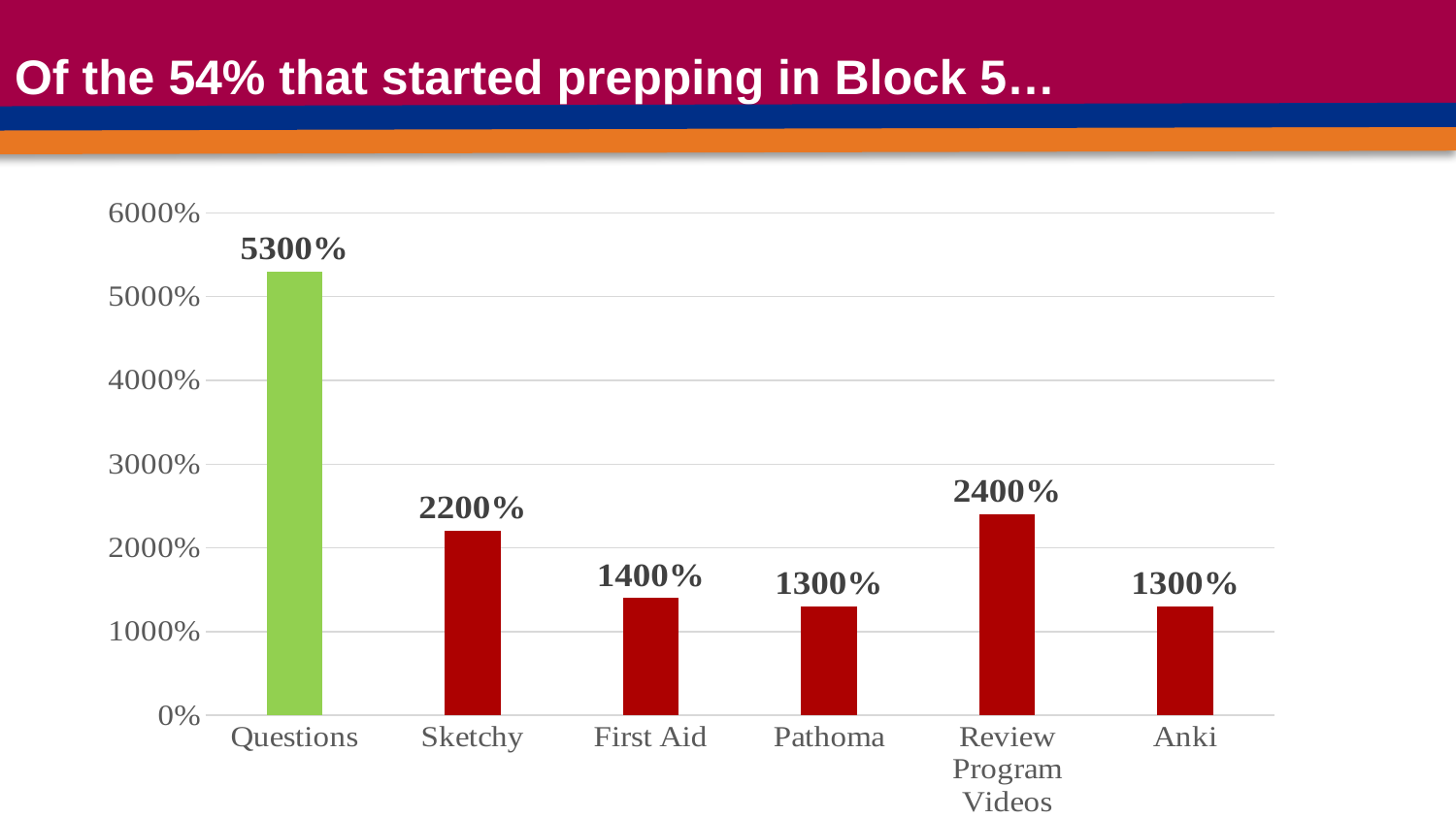
What is the difference between the values for Questions and Sketchy? 3100% Which category has the highest value? Questions What is the value for Review Program Videos? 2400% What is the difference between the values for Review Program Videos and Pathoma? 1100% Which bar is coloured green rather than red? Questions What is the value for First Aid? 1400% What is the value for Questions? 5300% Is the value for First Aid greater or less than 2000%? less How many categories are shown on the x axis? 6 Which is larger, the value for Sketchy or the value for Review Program Videos? Review Program Videos What kind of chart is shown on the slide? bar chart What is the value for Sketchy? 2200%